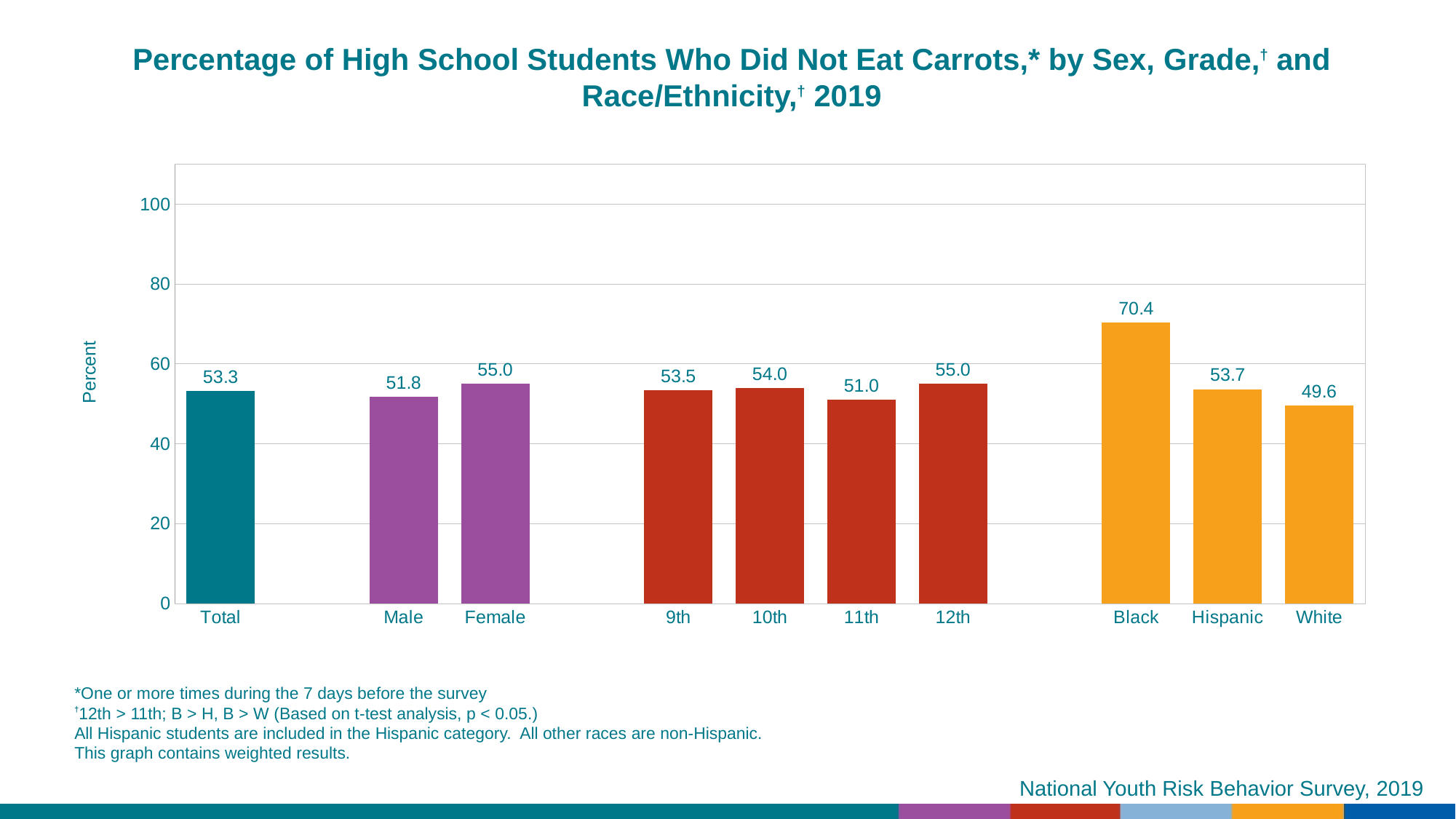
Which category has the lowest value? White What is the label of the y axis? Percent What is the difference between the Black and White values? 20.8 What kind of chart is this? bar chart What is the value for Black students? 70.4 Which is larger, the value for 12th grade or 11th grade? 12th What is the value for 11th grade? 51.0 Is the value for Black greater or less than 60? greater What is the difference between the Female and Male values? 3.2 What is the value for Total? 53.3 How many categories are shown on the x axis? 10 Which category has the highest value? Black